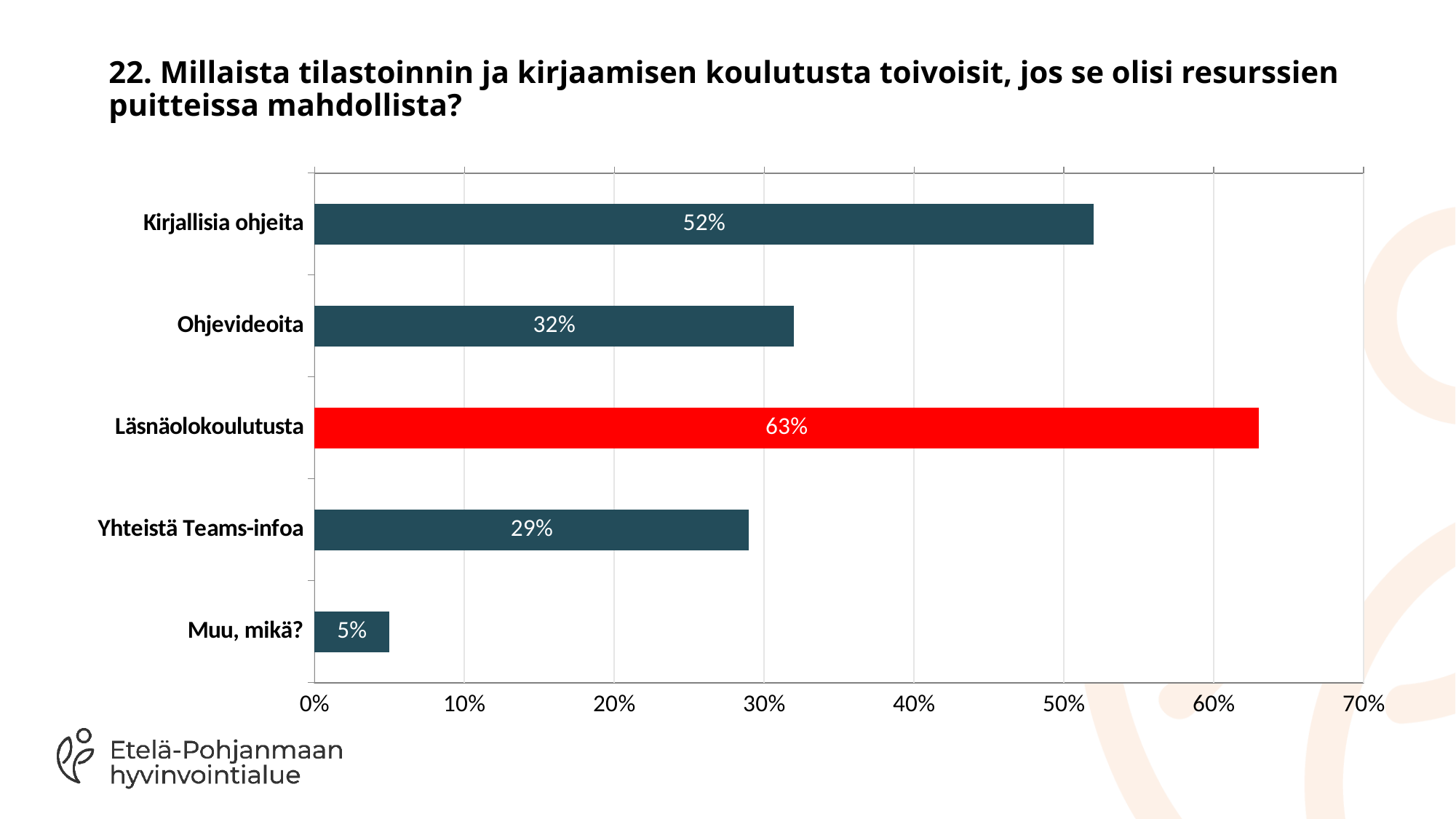
Which is larger, the value for Ohjevideoita or the value for Yhteistä Teams-infoa? Ohjevideoita Which category has the lowest value? Muu, mikä? What is the value for Yhteistä Teams-infoa? 29% Which category's bar is coloured red? Läsnäolokoulutusta What is the value for Läsnäolokoulutusta? 63% What kind of chart is shown on the slide? Bar chart How many categories are shown in the chart? 5 What is the value for Kirjallisia ohjeita? 52% What is the value for Ohjevideoita? 32% Which category has the highest value? Läsnäolokoulutusta What is the value for Muu, mikä? 5% What is the difference between the values for Läsnäolokoulutusta and Kirjallisia ohjeita? 11%